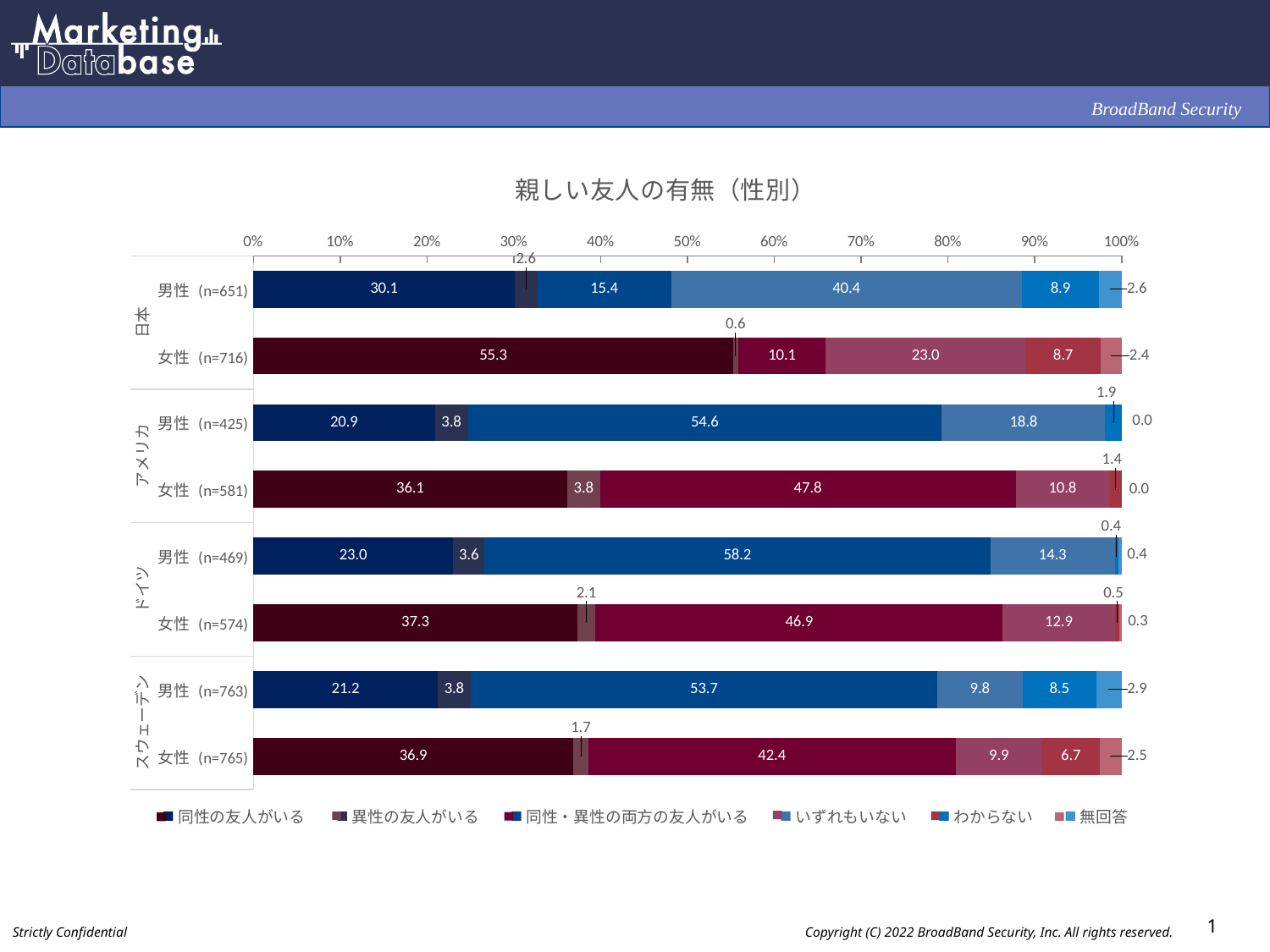
Which group has the highest value for 同性の友人がいる? 日本 女性 (n=716) How many series does the legend list? 6 Which group has the lowest value for 同性・異性の両方の友人がいる? 日本 女性 (n=716) What is the difference between the 同性・異性の両方の友人がいる values for アメリカ 男性 (n=425) and アメリカ 女性 (n=581)? 6.8 What is the value of 同性・異性の両方の友人がいる for ドイツ 男性 (n=469)? 58.2 Which is larger: the いずれもいない value for ドイツ 男性 (n=469) or for ドイツ 女性 (n=574)? ドイツ 男性 (n=469) What is the value of いずれもいない for 日本 男性 (n=651)? 40.4 How many respondent groups (bars) are plotted in the chart? 8 What is the title of the chart? 親しい友人の有無（性別） What kind of chart is shown on the slide? stacked bar chart What is the value of 同性の友人がいる for 日本 女性 (n=716)? 55.3 What is the value of わからない for スウェーデン 女性 (n=765)? 6.7